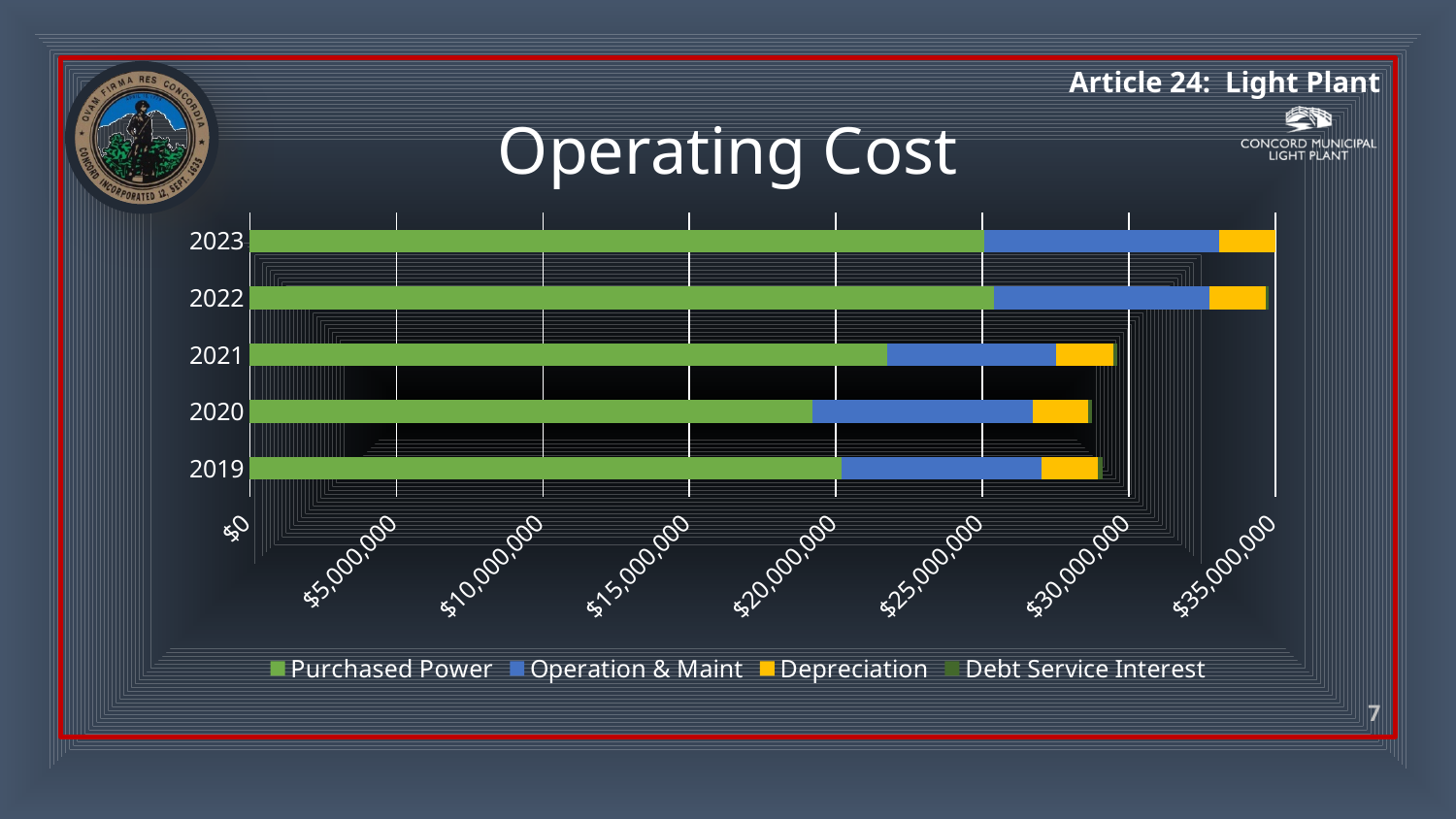
Is the total operating cost for 2020 greater or less than $30,000,000? less What kind of chart is shown on the slide? bar chart How many series does the legend list? 4 Which year has the lowest Purchased Power value? 2020 Which year has the larger total operating cost, 2021 or 2020? 2021 Is the Purchased Power value for 2020 greater or less than $20,000,000? less Is the Purchased Power value for 2021 greater or less than $20,000,000? greater Which series is shown in yellow in the legend? Depreciation How many years are shown on the chart? 5 What is the title of the chart? Operating Cost Which year has the larger Purchased Power value, 2021 or 2019? 2021